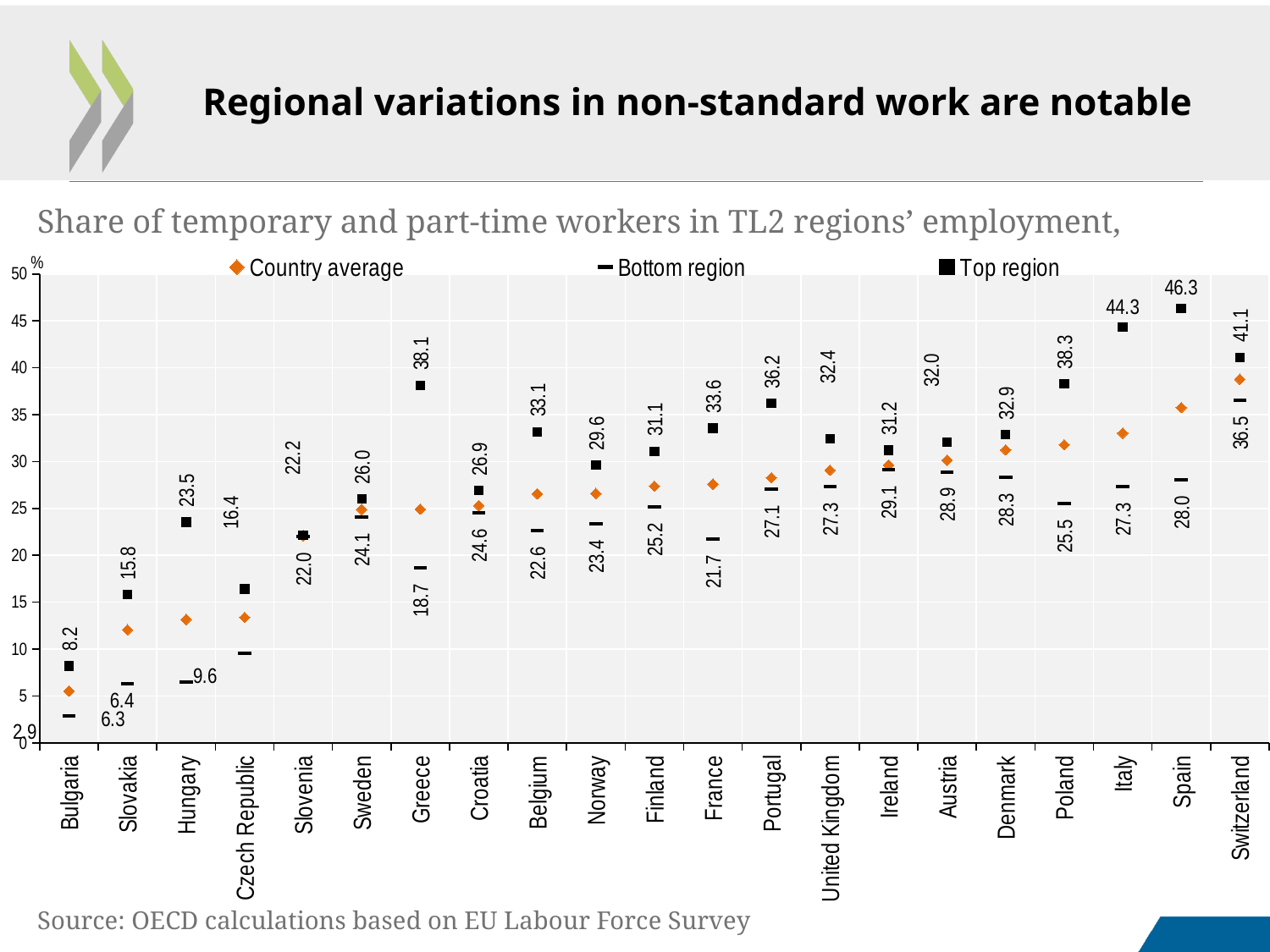
What is the difference between the Top region and Bottom region values for Spain? 18.3 Which country has the highest Bottom region value? Switzerland Is the Country average value for Switzerland greater or less than 35? greater Which country has the lowest Top region value? Bulgaria Which country has the highest Top region value? Spain What is the Top region value for Italy? 44.3 Is the Country average value for Bulgaria greater or less than 10? less How many series does the legend list? 3 Which is larger, the Top region value for Italy or for Poland? Italy How many countries are shown on the x axis? 21 What is the Top region value for Greece? 38.1 What is the Bottom region value for Switzerland? 36.5